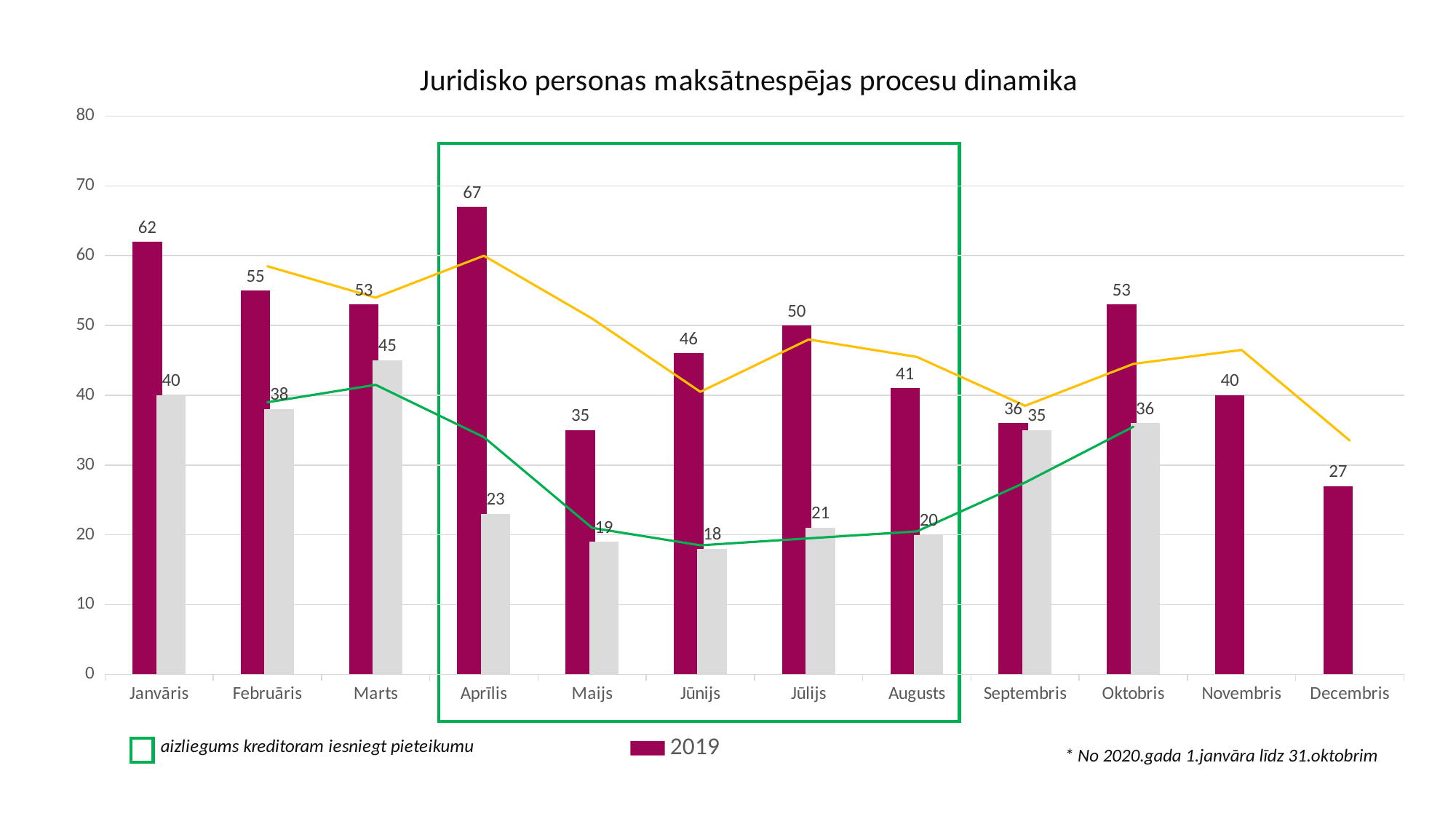
How many months are shown on the x axis? 12 What is the value of the 2019 bar for Aprīlis? 67 Do the 2019 bar values rise or fall from Aprīlis to Maijs? fall Which month has the lowest grey bar? Jūnijs What is the value of the grey bar for Jūnijs? 18 Which month has the highest 2019 bar? Aprīlis Which is larger for Marts: the 2019 bar or the grey bar? the 2019 bar What kind of chart is this? bar chart with line overlays What is the value of the 2019 bar for Decembris? 27 Which month has the lowest 2019 bar? Decembris What is the difference between the 2019 bar and the grey bar for Aprīlis? 44 What is the title of the chart? Juridisko personas maksātnespējas procesu dinamika